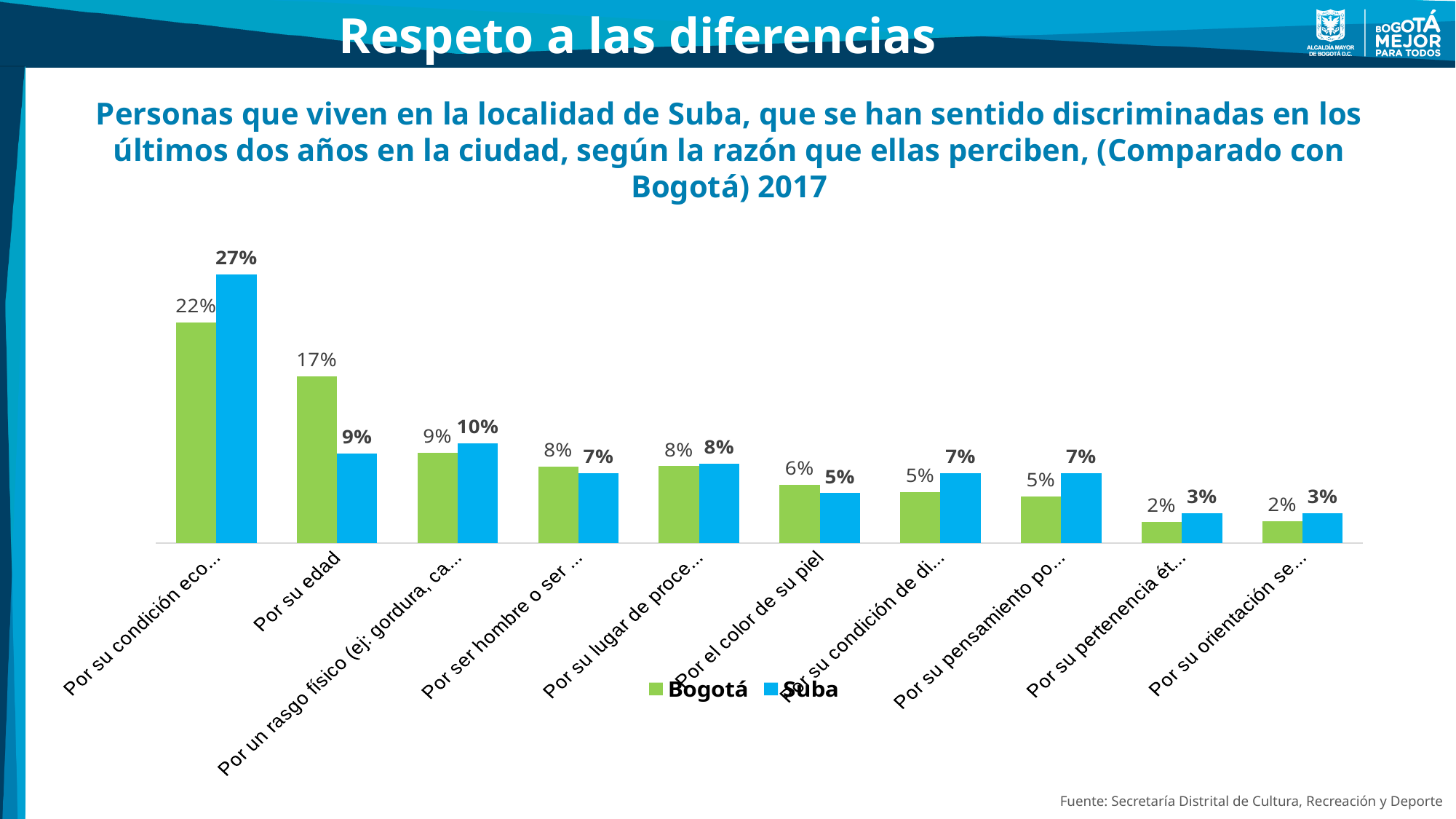
What kind of chart is shown on the slide? Bar chart Which category has the highest Suba value? Por su condición eco... How many categories are shown on the x axis? 10 What is the Suba value for the first category, 'Por su condición eco...'? 27% What is the difference between the Suba and Bogotá values for the first category, 'Por su condición eco...'? 5% For 'Por el color de su piel', which is larger, the Bogotá value or the Suba value? Bogotá How many series does the legend list? 2 What is the Bogotá value for 'Por su edad'? 17% For 'Por su edad', which is larger, the Bogotá value or the Suba value? Bogotá What is the Bogotá value for 'Por el color de su piel'? 6% What is the Suba value for 'Por su edad'? 9% What is the difference between the Bogotá and Suba values for 'Por su edad'? 8%